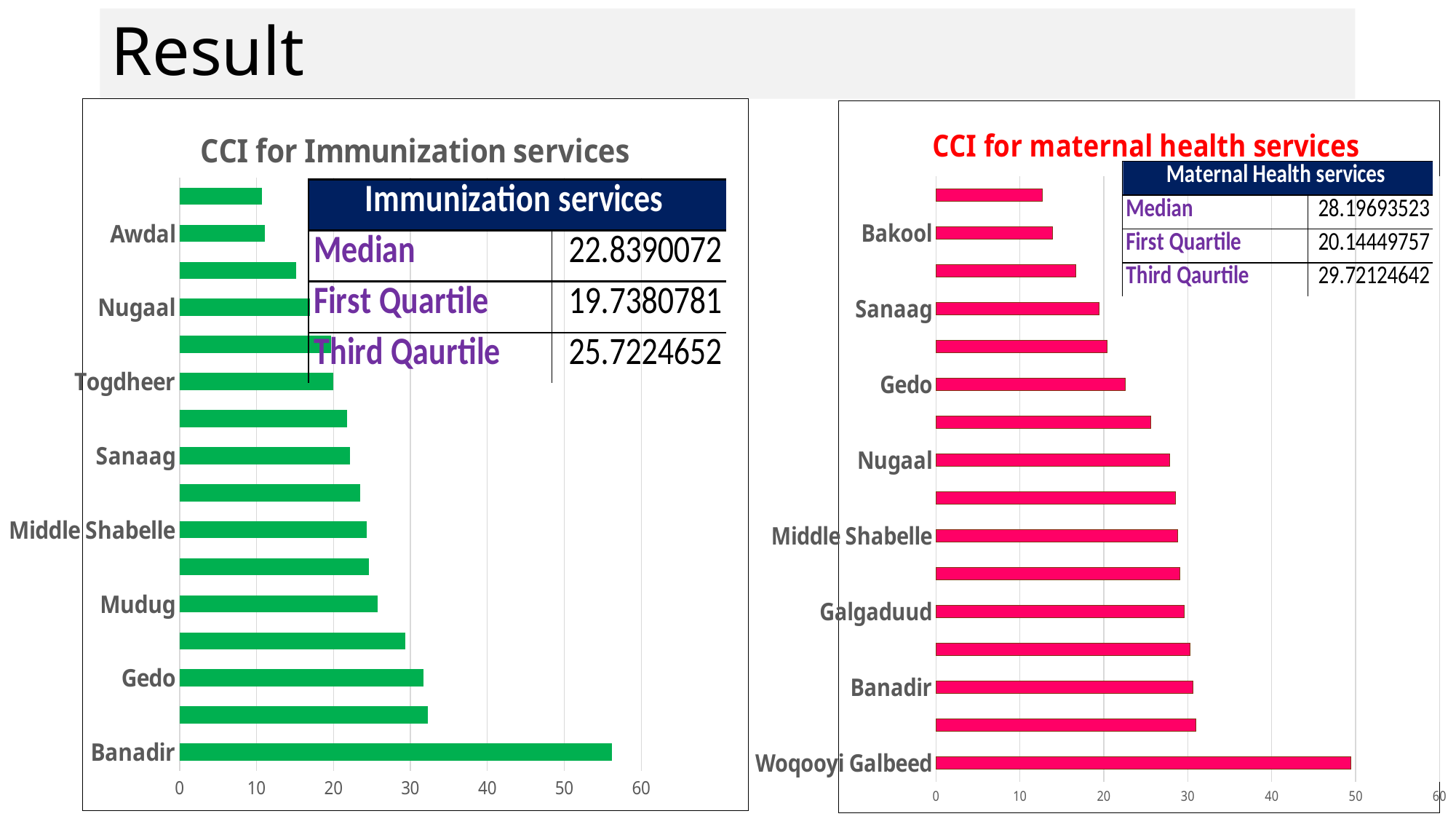
What is the Third Qaurtile value shown in the table on the 'CCI for maternal health services' chart? 29.72124642 What is the Median value shown in the table on the 'CCI for Immunization services' chart? 22.8390072 In the 'CCI for maternal health services' chart, is the value for Gedo greater or less than 30? less In the 'CCI for maternal health services' chart, is the value for Woqooyi Galbeed greater or less than 40? greater In the 'CCI for Immunization services' chart, which region has the highest value? Banadir How many bars are plotted in the 'CCI for maternal health services' chart? 16 What colour are the bars in the 'CCI for maternal health services' chart? red In the 'CCI for Immunization services' chart, is the value for Awdal greater or less than 20? less What kind of chart is the 'CCI for Immunization services' chart? bar chart In the 'CCI for maternal health services' chart, which region has the highest value? Woqooyi Galbeed In the 'CCI for Immunization services' chart, which is larger, the value for Gedo or the value for Mudug? Gedo